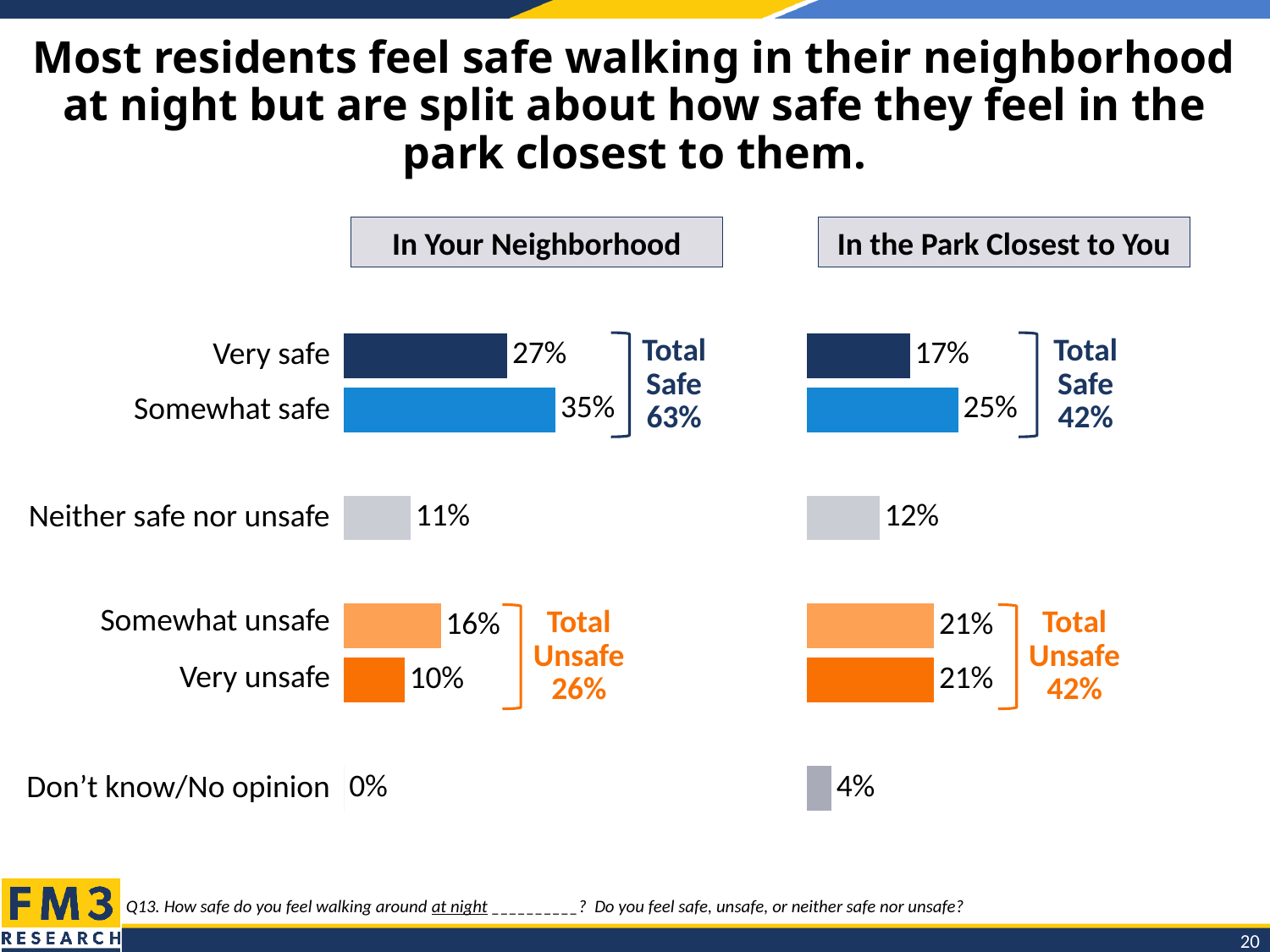
In the 'In the Park Closest to You' chart, what is the Total Safe value? 42% Which is larger: the very safe value in the 'In Your Neighborhood' chart or the very safe value in the 'In the Park Closest to You' chart? In Your Neighborhood In the 'In Your Neighborhood' chart, which category has the highest value? Somewhat safe In the 'In Your Neighborhood' chart, which category has the lowest value? Don't know/No opinion In the 'In Your Neighborhood' chart, what percentage of residents feel very safe? 27% In the 'In Your Neighborhood' chart, what is the Total Unsafe value? 26% In the 'In the Park Closest to You' chart, what percentage of residents feel somewhat unsafe? 21% In the 'In the Park Closest to You' chart, which category has the lowest value? Don't know/No opinion In the 'In Your Neighborhood' chart, what is the difference between the somewhat safe and very safe values? 8% In the 'In the Park Closest to You' chart, what is the difference between the Total Safe and Total Unsafe values? 0% How many response categories are shown in the 'In Your Neighborhood' chart? 6 What kind of chart is used on this slide? Bar chart